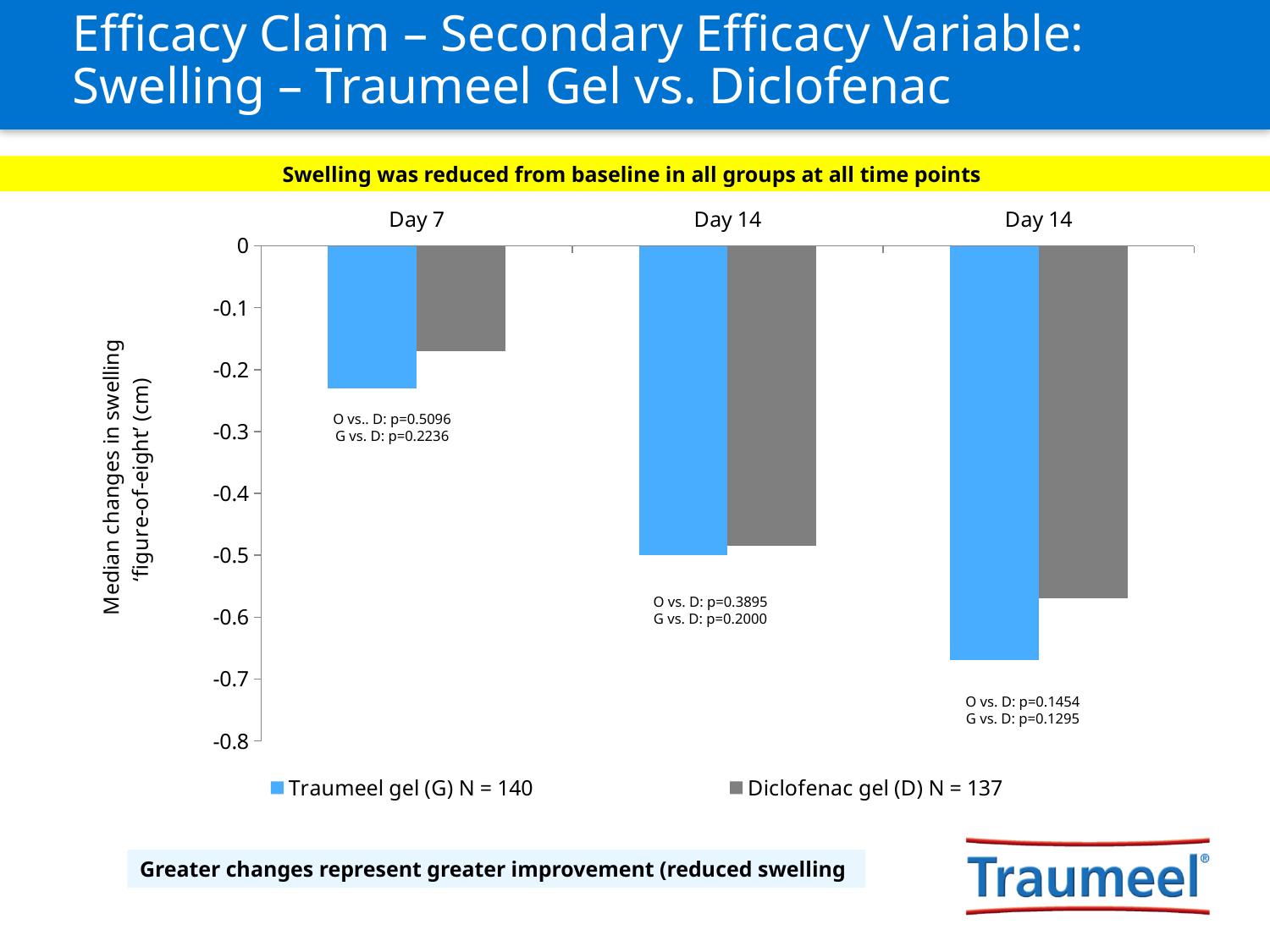
What is the y-axis label of the chart? Median changes in swelling 'figure-of-eight' (cm) Is the value for Diclofenac gel in the Day 7 group greater or less than -0.2? greater How many series does the legend list? 2 In the Day 7 group, which series has the bar extending further below zero, Traumeel gel or Diclofenac gel? Traumeel gel Which bar on the chart has the lowest (most negative) value? Traumeel gel in the rightmost group Which series is shown in blue according to the legend? Traumeel gel (G) N = 140 Do the Traumeel gel values rise or fall moving from the leftmost group to the rightmost group? fall Is the value for Traumeel gel in the rightmost group greater or less than -0.6? less How many time-point groups are plotted along the x axis? 3 What kind of chart is shown on the slide? bar chart Is the value for Traumeel gel in the Day 7 group greater or less than -0.2? less